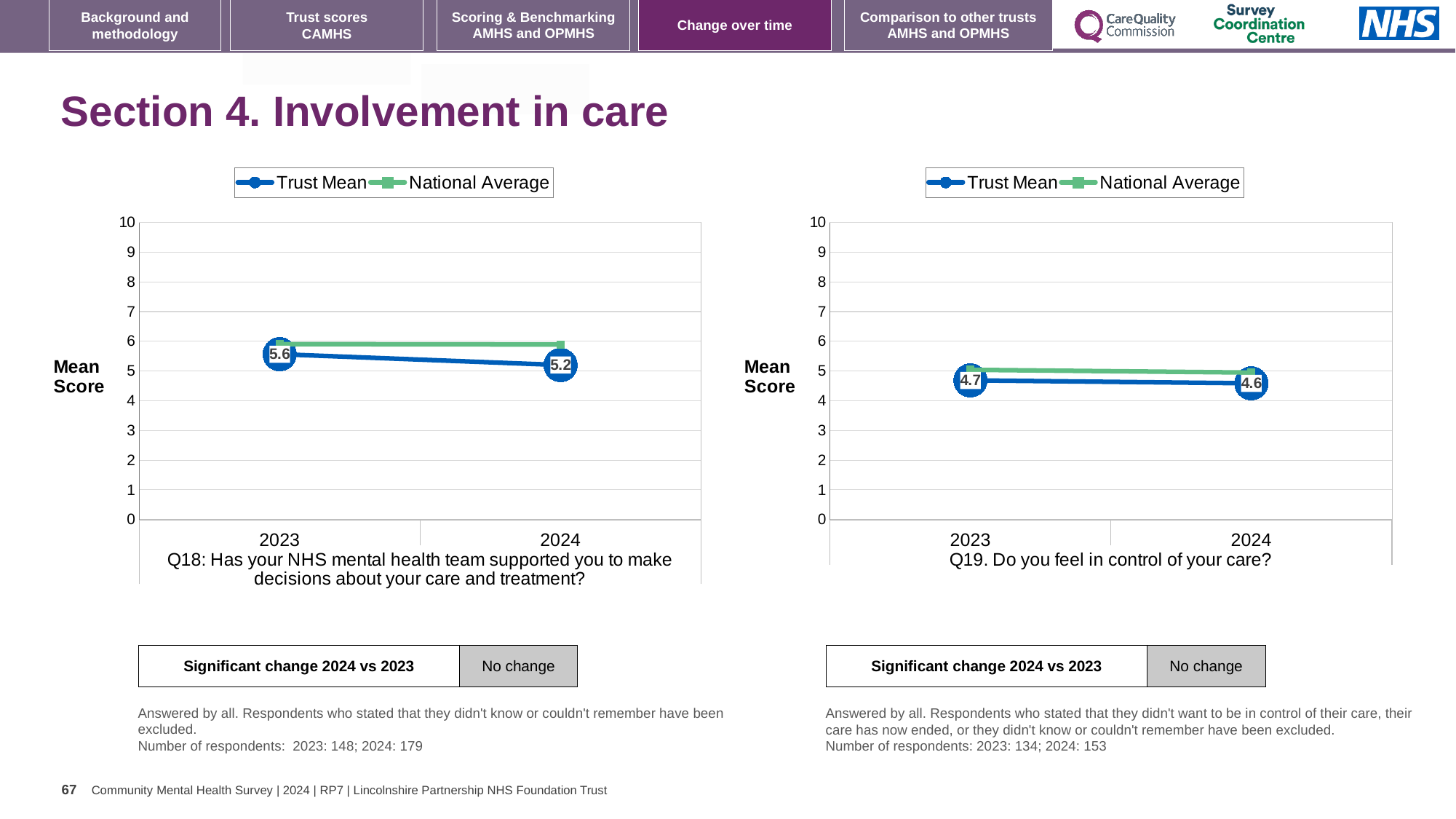
In the Q18 chart on the left, by how much did the Trust Mean fall from 2023 to 2024? 0.4 What kind of chart is the Q19 chart on the right? line chart How many years are plotted on the x axis of the Q19 chart on the right? 2 In the Q19 chart on the right, what is the Trust Mean score for 2023? 4.7 In the Q18 chart on the left, is the National Average for 2024 greater or less than 5? greater In the Q19 chart on the right, what is the Trust Mean score for 2024? 4.6 In the Q18 chart on the left, what is the Trust Mean score for 2023? 5.6 In the Q18 chart on the left, does the Trust Mean rise or fall from 2023 to 2024? fall In the Q18 chart on the left, which is higher in 2023, the Trust Mean or the National Average? National Average How many series does the legend of the Q18 chart on the left list? 2 In the Q19 chart on the right, what is the difference between the Trust Mean for 2023 and 2024? 0.1 In the Q18 chart on the left, what is the Trust Mean score for 2024? 5.2